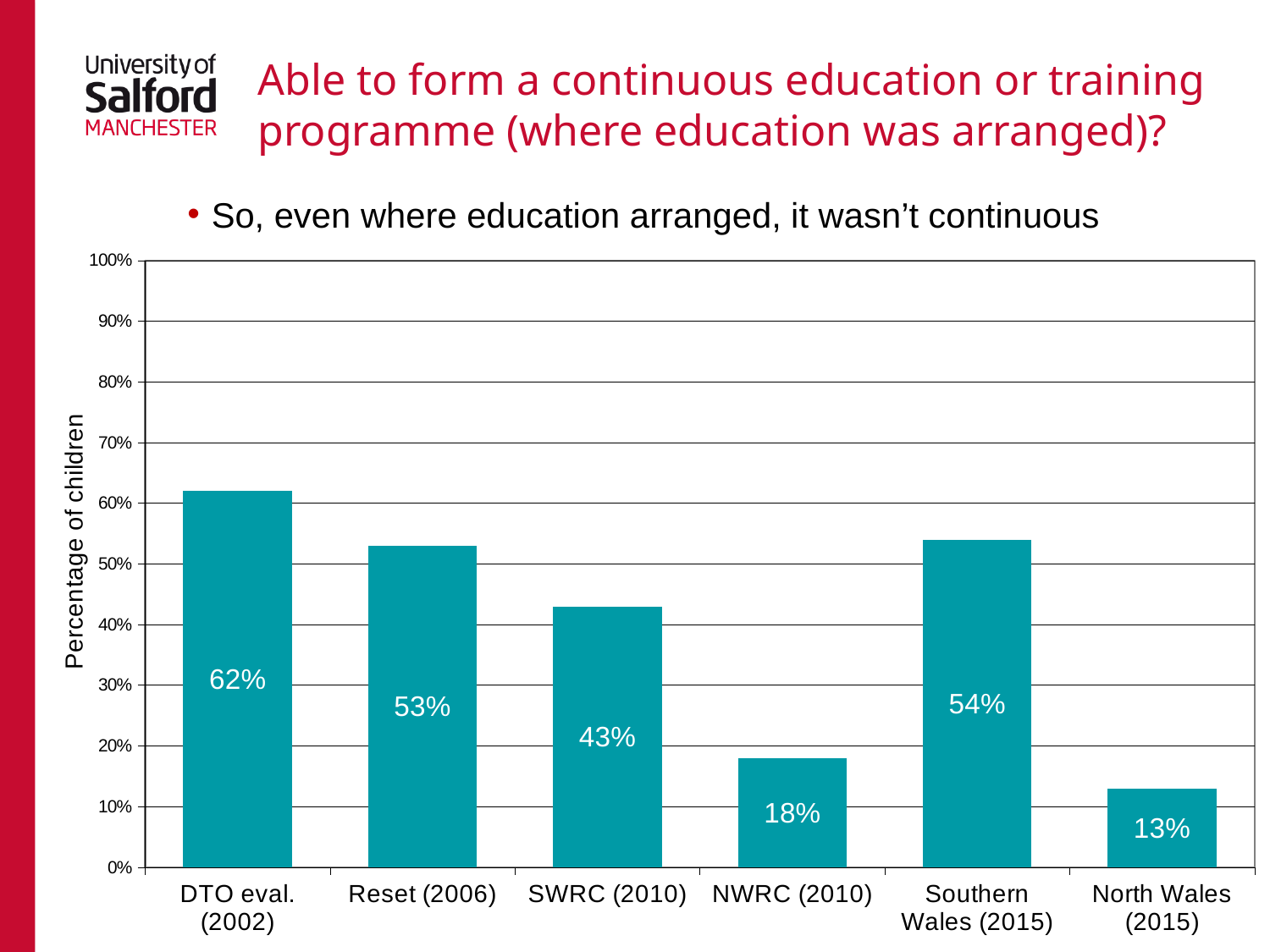
What is the difference between the values for Reset (2006) and SWRC (2010)? 10% What is the difference between the values for DTO eval. (2002) and North Wales (2015)? 49% What is the value for NWRC (2010)? 18% How many categories are shown on the x axis? 6 Which category has the lowest value? North Wales (2015) What is the label of the y axis? Percentage of children What is the value for DTO eval. (2002)? 62% Which is larger, the value for Reset (2006) or the value for Southern Wales (2015)? Southern Wales (2015) What kind of chart is shown on the slide? bar chart Which category has the highest value? DTO eval. (2002) What is the value for Southern Wales (2015)? 54% Is the value for SWRC (2010) greater or less than 50%? less